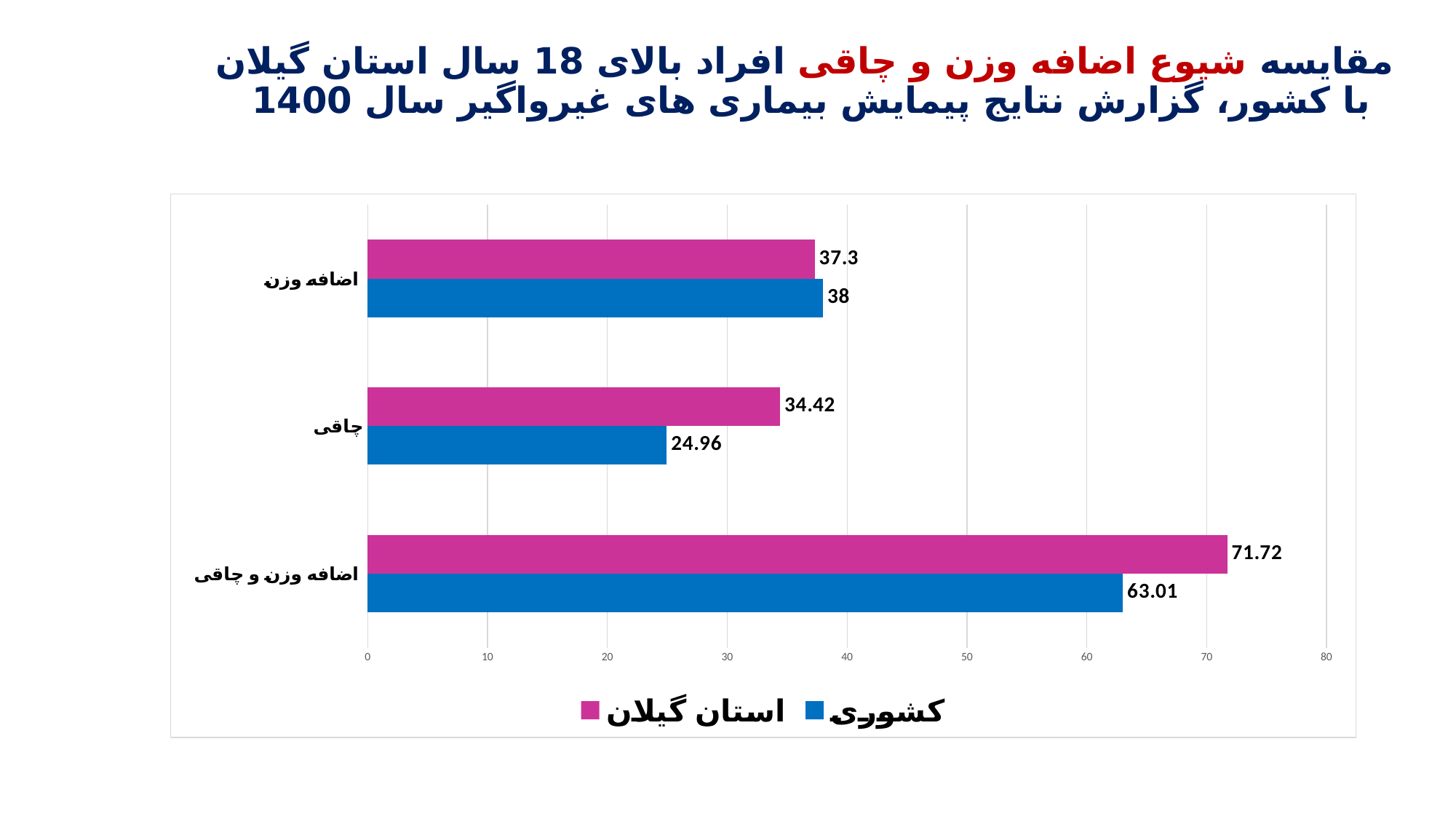
Which category has the lowest value for the استان گیلان series? چاقی What is the value for کشوری in the اضافه وزن category? 38 What is the value for استان گیلان in the اضافه وزن و چاقی category? 71.72 What is the difference between the استان گیلان and کشوری values in the چاقی category? 9.46 In the چاقی category, which series has the larger value, استان گیلان or کشوری? استان گیلان What is the value for استان گیلان in the اضافه وزن category? 37.3 What is the difference between the استان گیلان and کشوری values in the اضافه وزن و چاقی category? 8.71 How many series does the legend list? 2 What kind of chart is shown on the slide? Bar chart What is the value for کشوری in the چاقی category? 24.96 Which category has the highest value for the کشوری series? اضافه وزن و چاقی How many categories are shown on the chart? 3